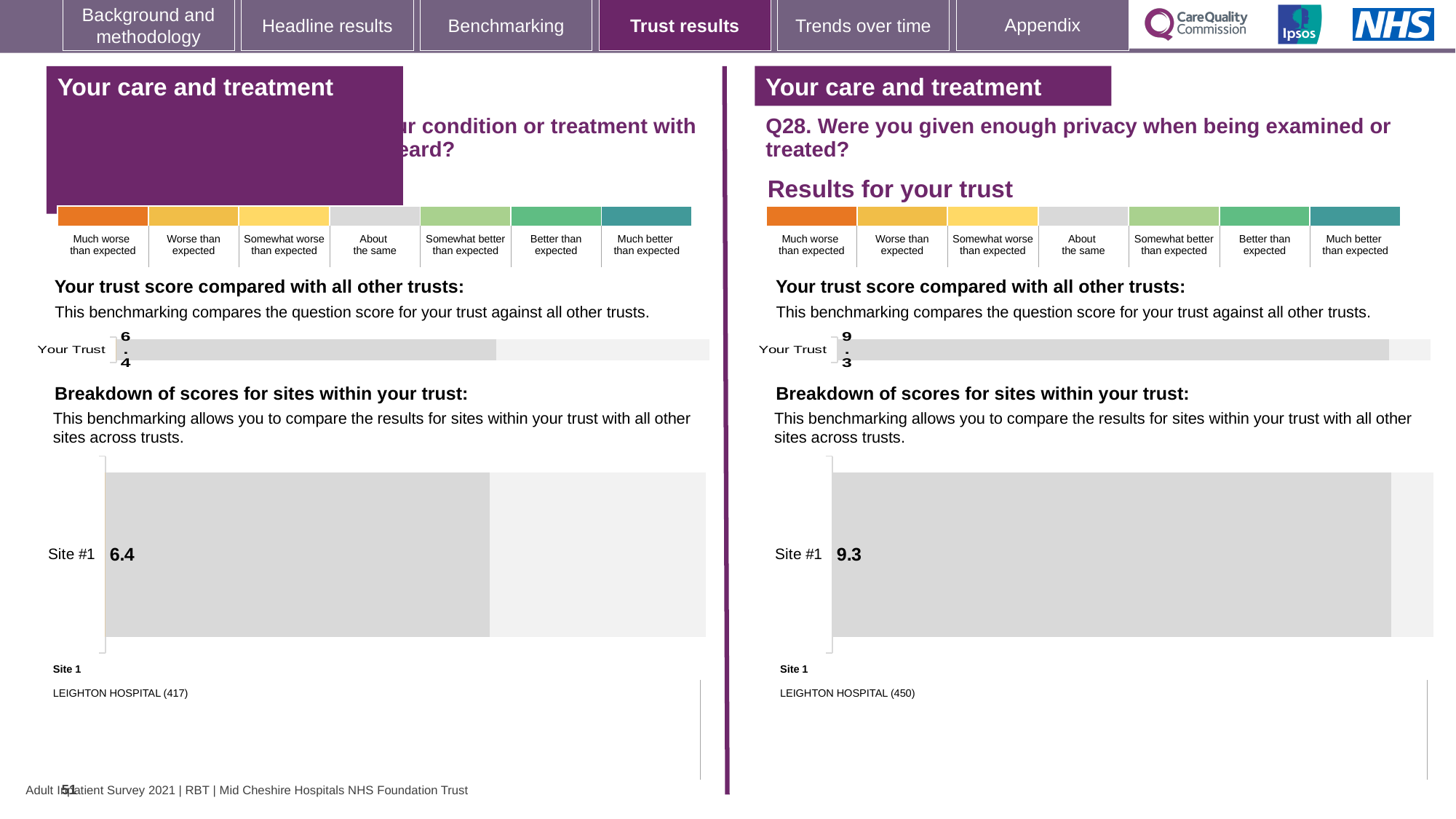
On the right panel (Q28), which hospital is listed as Site 1? LEIGHTON HOSPITAL (450) What type of chart is used to show the Site #1 score on the left panel? bar chart On the left panel, which hospital is listed as Site 1? LEIGHTON HOSPITAL (417) On the right panel (Q28), is the Site #1 score greater or less than the Your Trust score, or are they equal? equal On the right panel (Q28), what score is shown for Site #1 in the breakdown of scores for sites within your trust? 9.3 How many sites are shown in the breakdown of scores chart on the right panel (Q28)? 1 On the right panel (Q28), what is the score shown for Your Trust? 9.3 What is the difference between the Your Trust score on the right panel (Q28) and the Your Trust score on the left panel? 2.9 What is the difference between the Site #1 score on the right panel (Q28) and the Site #1 score on the left panel? 2.9 On the left panel, what is the score shown for Your Trust? 6.4 On the left panel, what score is shown for Site #1 in the breakdown of scores for sites within your trust? 6.4 Which panel shows the higher Your Trust score, the left panel or the right panel (Q28)? right panel (Q28)